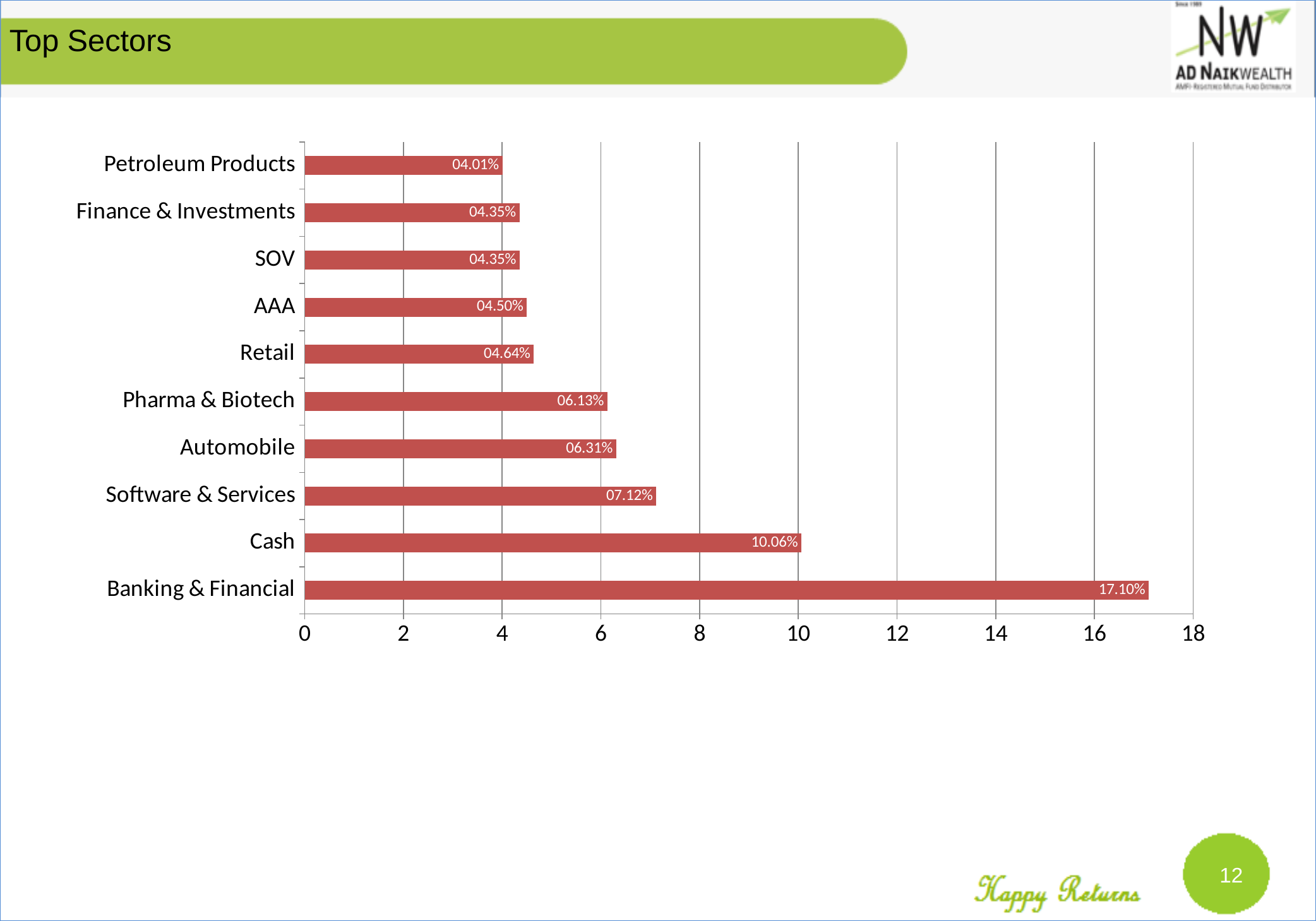
What is the value for Banking & Financial? 17.10% How many sectors are shown in the chart? 10 Which is larger, the value for Software & Services or the value for Automobile? Software & Services What kind of chart is shown on the slide? bar chart What is the value for Pharma & Biotech? 06.13% Is the value for Cash greater or less than 8? greater What is the value for Cash? 10.06% What is the value for Petroleum Products? 04.01% What is the difference between the values for Banking & Financial and Cash? 7.04% What is the title of the slide containing the chart? Top Sectors Which sector has the lowest value? Petroleum Products Which sector has the highest value? Banking & Financial